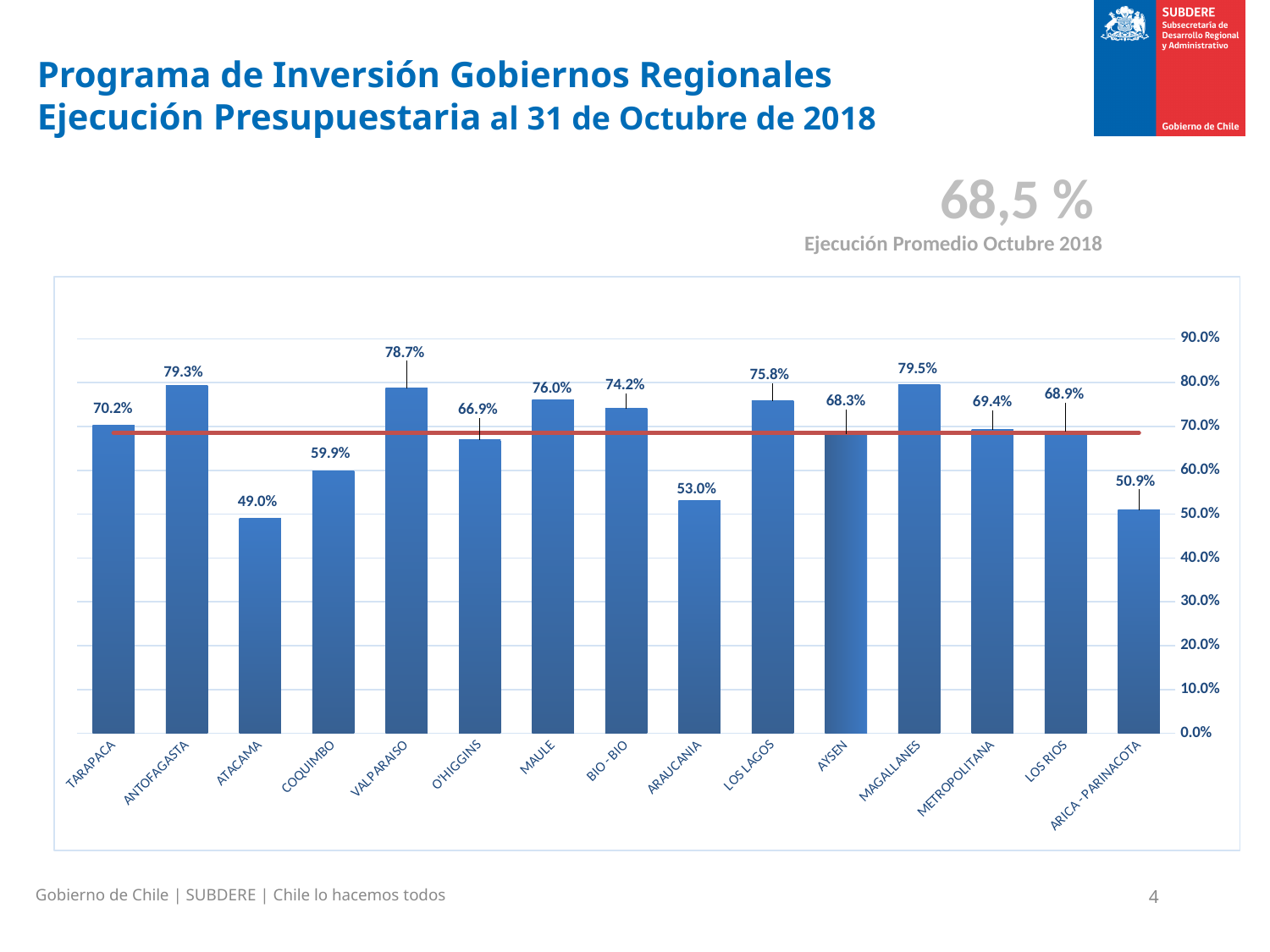
What is the value for ATACAMA? 49.0% Which is larger, the value for MAULE or the value for BIO - BIO? MAULE Which region has the lowest value? ATACAMA Which region has the highest value? MAGALLANES What is the value for ARICA - PARINACOTA? 50.9% What is the difference between the values for ANTOFAGASTA and ATACAMA? 30.3% What is the value for VALPARAISO? 78.7% How many regions are shown on the x axis? 15 What kind of chart is shown on the slide? bar chart What average execution value is shown above the chart for October 2018? 68,5 % Is the value for ARAUCANIA greater or less than 60.0%? less What is the value for LOS LAGOS? 75.8%